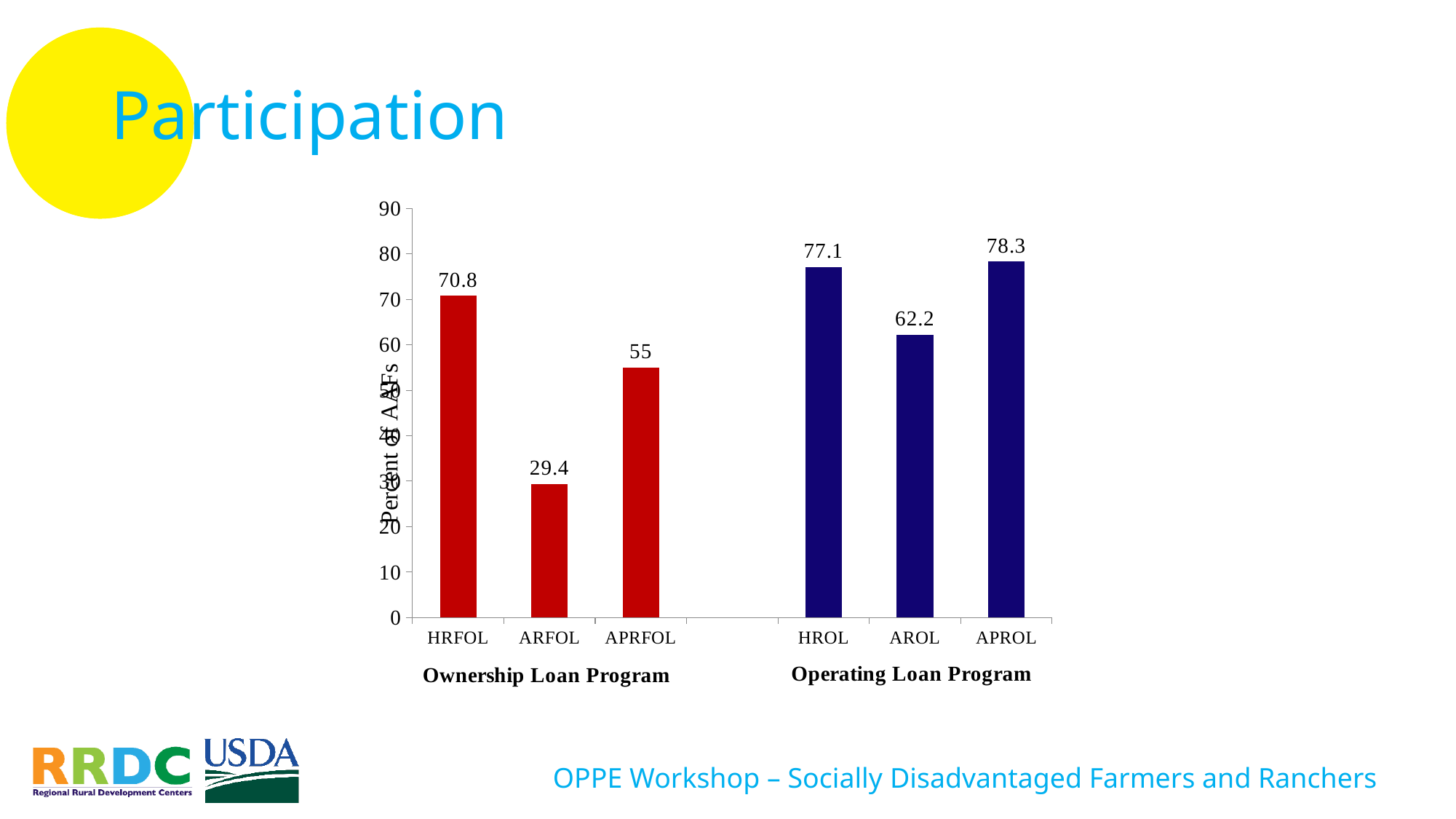
Which category has the lowest value? ARFOL What are the two group labels shown below the x axis? Ownership Loan Program and Operating Loan Program What kind of chart is shown on the slide? Bar chart What is the value for AROL? 62.2 What is the value for APROL? 78.3 How many bars are plotted in the chart? 6 What is the value for ARFOL? 29.4 What is the value for HRFOL? 70.8 Which category has the highest value? APROL What is the difference between the values for HROL and AROL? 14.9 What is the difference between the values for HRFOL and ARFOL? 41.4 Which is larger, the value for APRFOL or the value for AROL? AROL